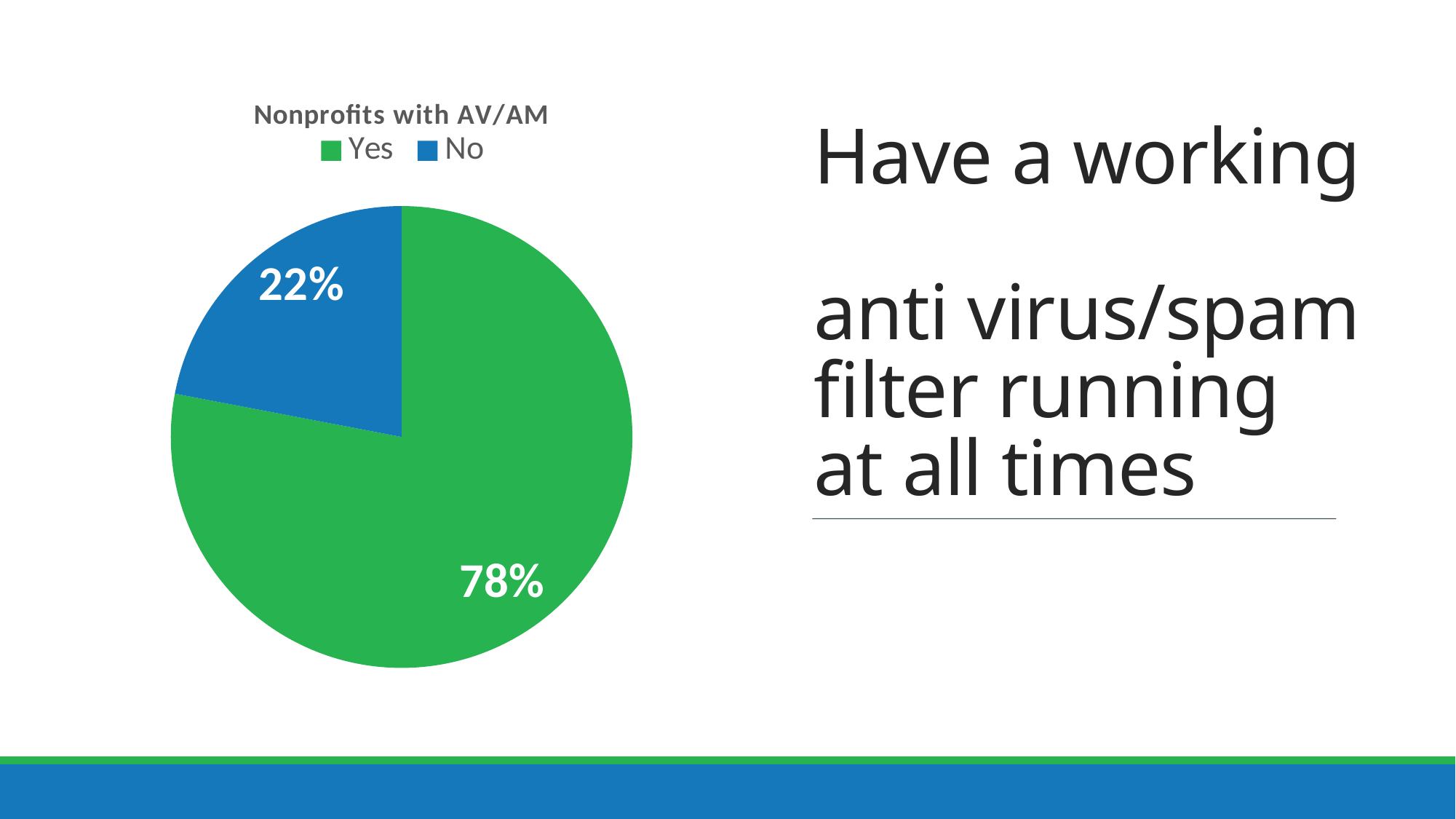
What percentage of the pie is labelled "Yes"? 78% What share of the pie does the "Yes" slice represent? 78% How many slices does the pie chart have? 2 What is the title of the chart? Nonprofits with AV/AM What colour is the "No" slice? blue Which is larger, the "Yes" slice or the "No" slice? Yes What percentage of the pie is labelled "No"? 22% What kind of chart is shown on the slide? pie chart Which slice of the pie is the smallest? No How many entries does the legend list? 2 What is the difference in percentage points between the "Yes" and "No" slices? 56 Which slice of the pie is the largest? Yes